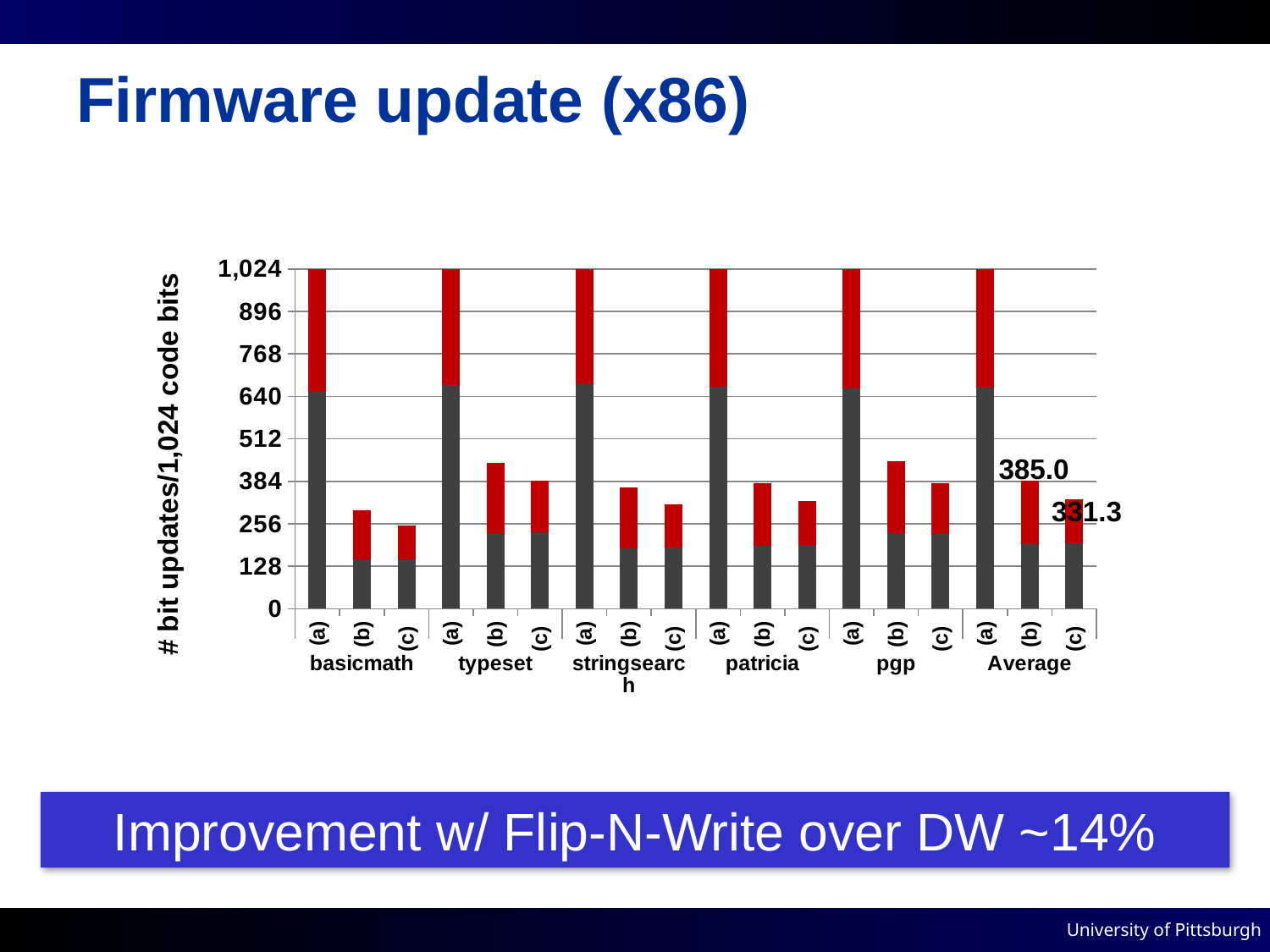
What kind of chart is shown on the slide? bar chart What is the total value of the Average (b) bar? 385.0 How many benchmark groups are shown along the x axis? 6 What is the y-axis title of the chart? # bit updates/1,024 code bits Is the total value for basicmath (b) greater or less than 384? less What is the total value of the Average (c) bar? 331.3 Is the total value for typeset (b) greater or less than 384? greater Which is larger, the Average (b) bar or the Average (c) bar? Average (b) How many bars are plotted in total? 18 What value does the basicmath (a) bar reach on the y axis? 1,024 Within the Average group, which configuration has the highest bar? (a) What is the difference between the Average (b) and Average (c) bar totals? 53.7